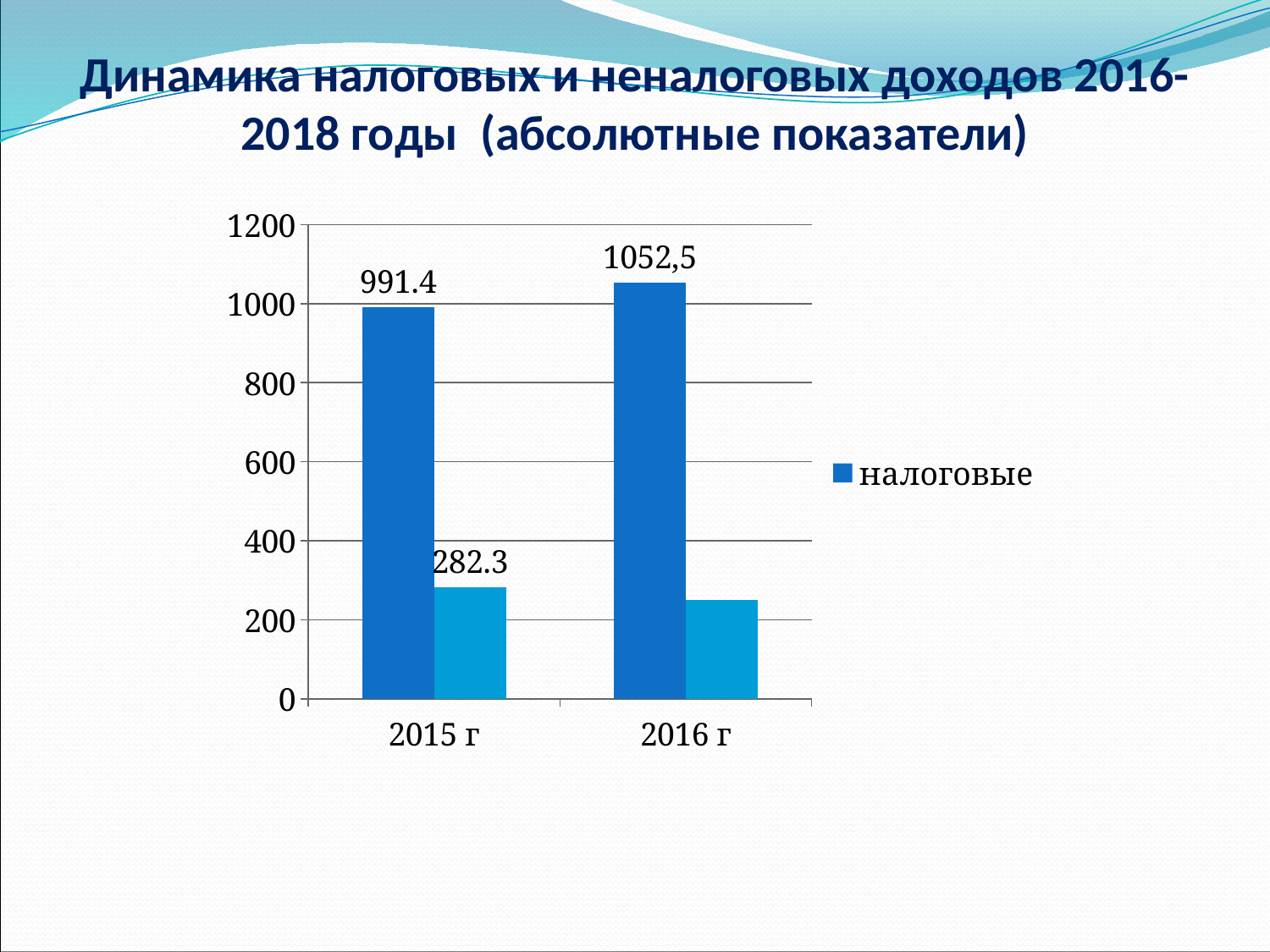
Is the value of the light blue bar for 2016 г greater or less than 200? greater How many series does the legend list? 1 Which is larger, the налоговые value for 2015 г or for 2016 г? 2016 г What is the value of налоговые for 2015 г? 991.4 What is the value shown on the light blue bar for 2015 г? 282.3 In which year is the налоговые value highest? 2016 г By how much does the налоговые value for 2016 г exceed that for 2015 г? 61.1 What is the value of налоговые for 2016 г? 1052,5 How many years (categories) are shown on the x axis? 2 Is the value of the light blue bar for 2016 г greater or less than 400? less What is the difference between the налоговые bar and the light blue bar for 2015 г? 709.1 What kind of chart is shown on the slide? bar chart